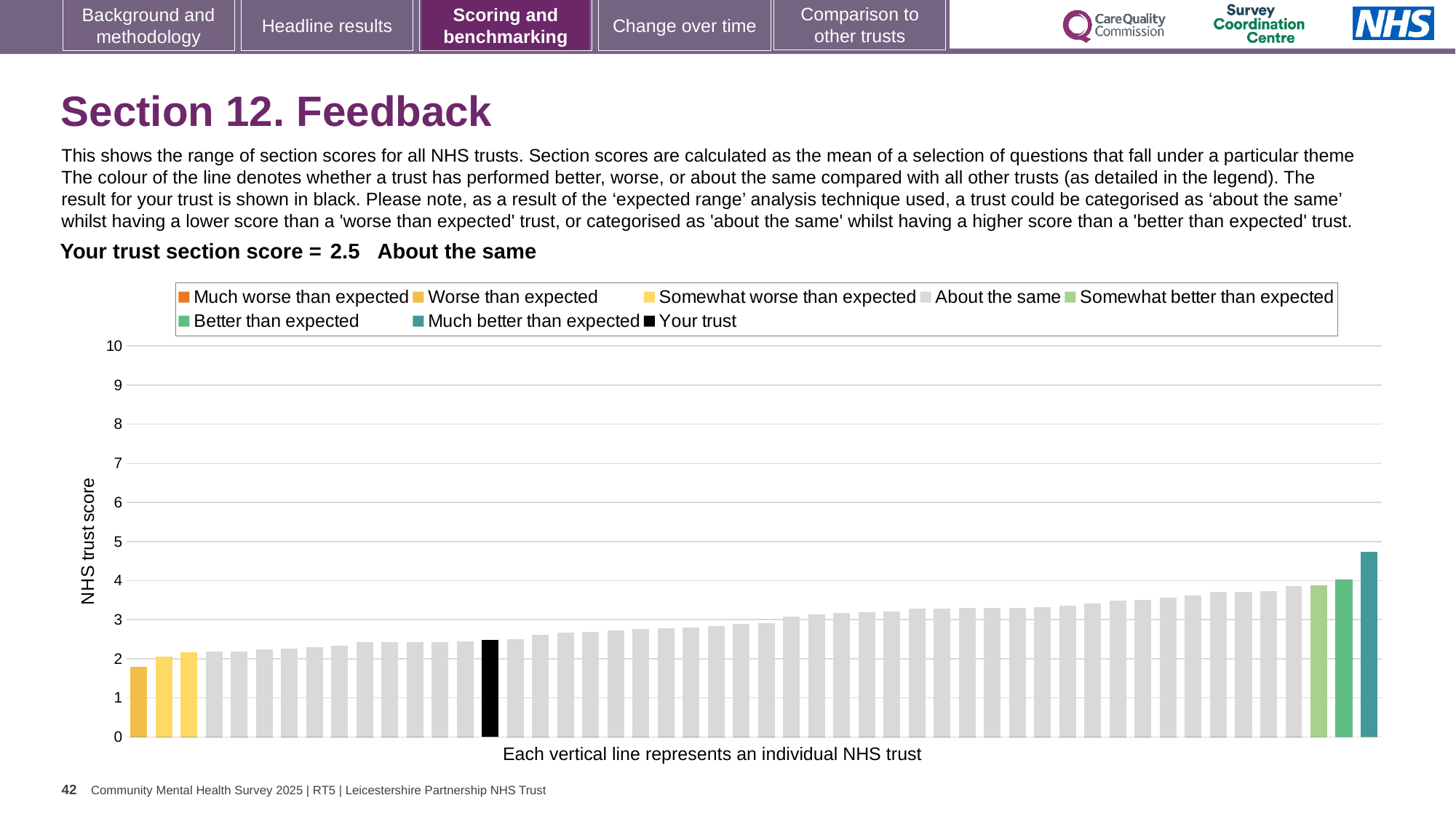
Is the value for your trust (the black bar) greater or less than 3? less Which legend category does the tallest bar belong to? Much better than expected What is the section score for your trust? 2.5 What kind of chart is shown on the slide? bar chart How many entries does the chart legend list? 8 Is the value of the tallest bar greater or less than 4? greater Which category is your trust placed in for this section? About the same Is the value for your trust (the black bar) greater or less than 2? greater Do the bar values rise or fall from left to right along the x axis? rise What is the label on the y axis of the chart? NHS trust score